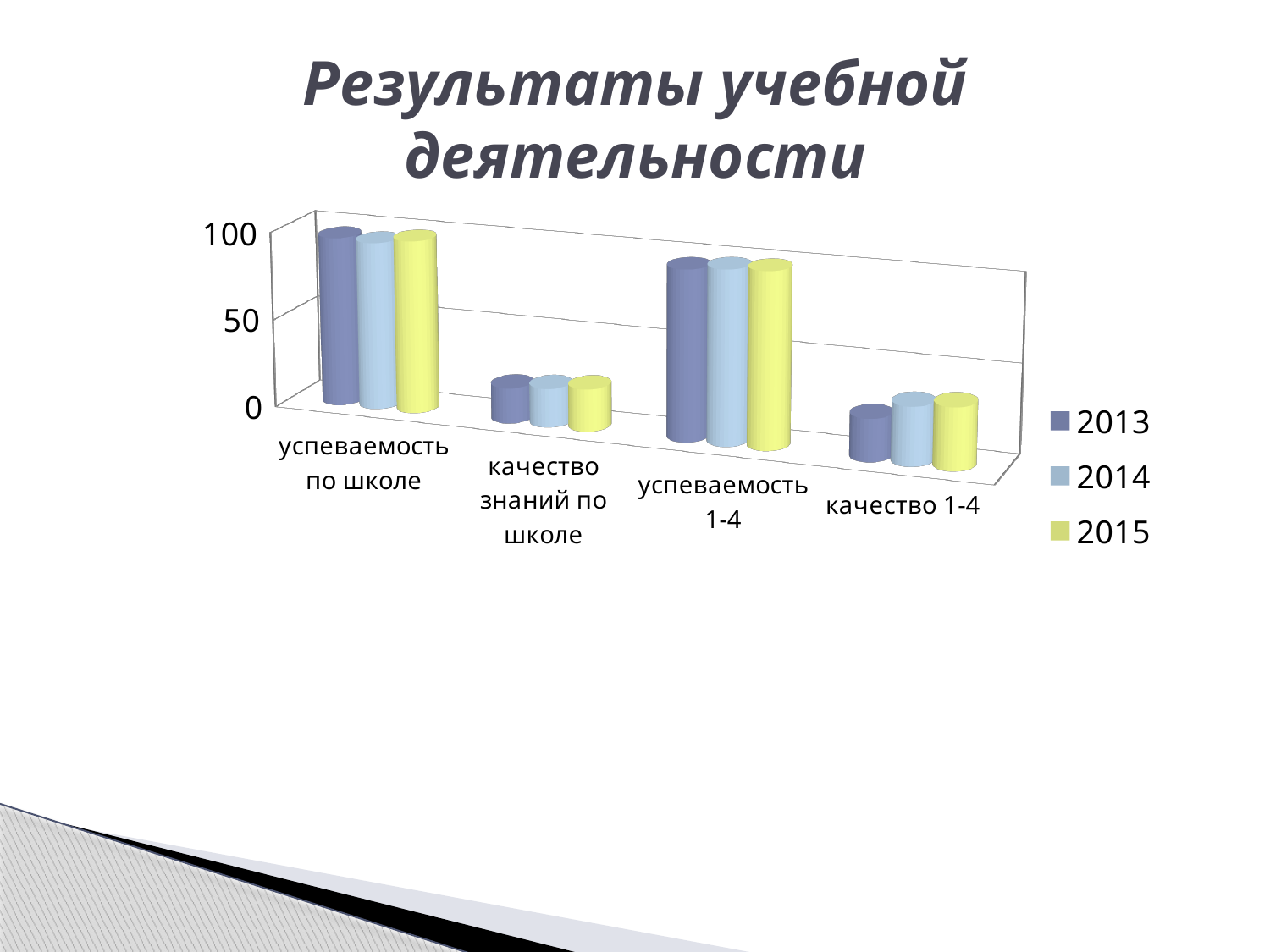
Is the value for 2013 in the category 'успеваемость по школе' greater or less than 50? greater How many series does the chart legend list? 3 Is the value for 2013 in the category 'качество 1-4' greater or less than 50? less For 2015, which is larger: the value for 'успеваемость по школе' or the value for 'качество знаний по школе'? успеваемость по школе Which category has the lowest bars in the chart? качество знаний по школе Which years are listed in the chart legend? 2013, 2014, 2015 For 2014, which is larger: the value for 'успеваемость 1-4' or the value for 'качество 1-4'? успеваемость 1-4 What kind of chart is shown on the slide? bar chart Is the value for 2014 in the category 'успеваемость 1-4' greater or less than 50? greater How many categories are shown on the x axis of the chart? 4 What is the title of the slide containing the chart? Результаты учебной деятельности